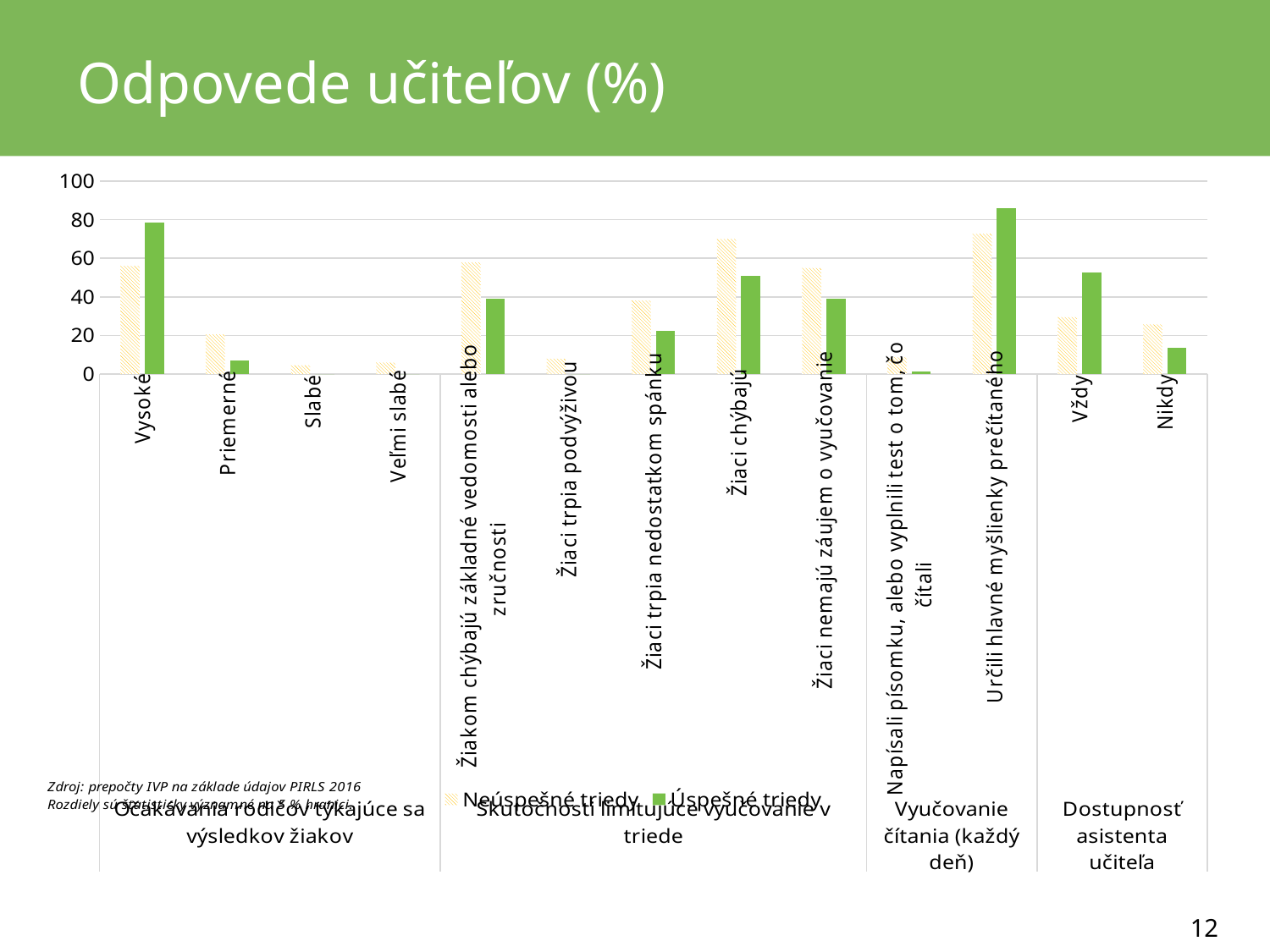
Is the Úspešné triedy value for Vysoké greater or less than 60? greater How many series does the legend list? 2 What kind of chart is shown on the slide? bar chart For the category Vždy, which series has the larger value, Neúspešné triedy or Úspešné triedy? Úspešné triedy What is the title of the chart on the slide? Odpovede učiteľov (%) For the category Žiaci nemajú záujem o vyučovanie, which series has the larger value, Neúspešné triedy or Úspešné triedy? Neúspešné triedy What are the two series named in the legend? Neúspešné triedy and Úspešné triedy Is the Úspešné triedy value for Nikdy greater or less than 20? less Which category has the highest value for the Neúspešné triedy series? Určili hlavné myšlienky prečítaného How many categories are plotted along the x axis? 13 Is the Neúspešné triedy value for Žiaci chýbajú greater or less than 60? greater Which category has the highest value for the Úspešné triedy series? Určili hlavné myšlienky prečítaného